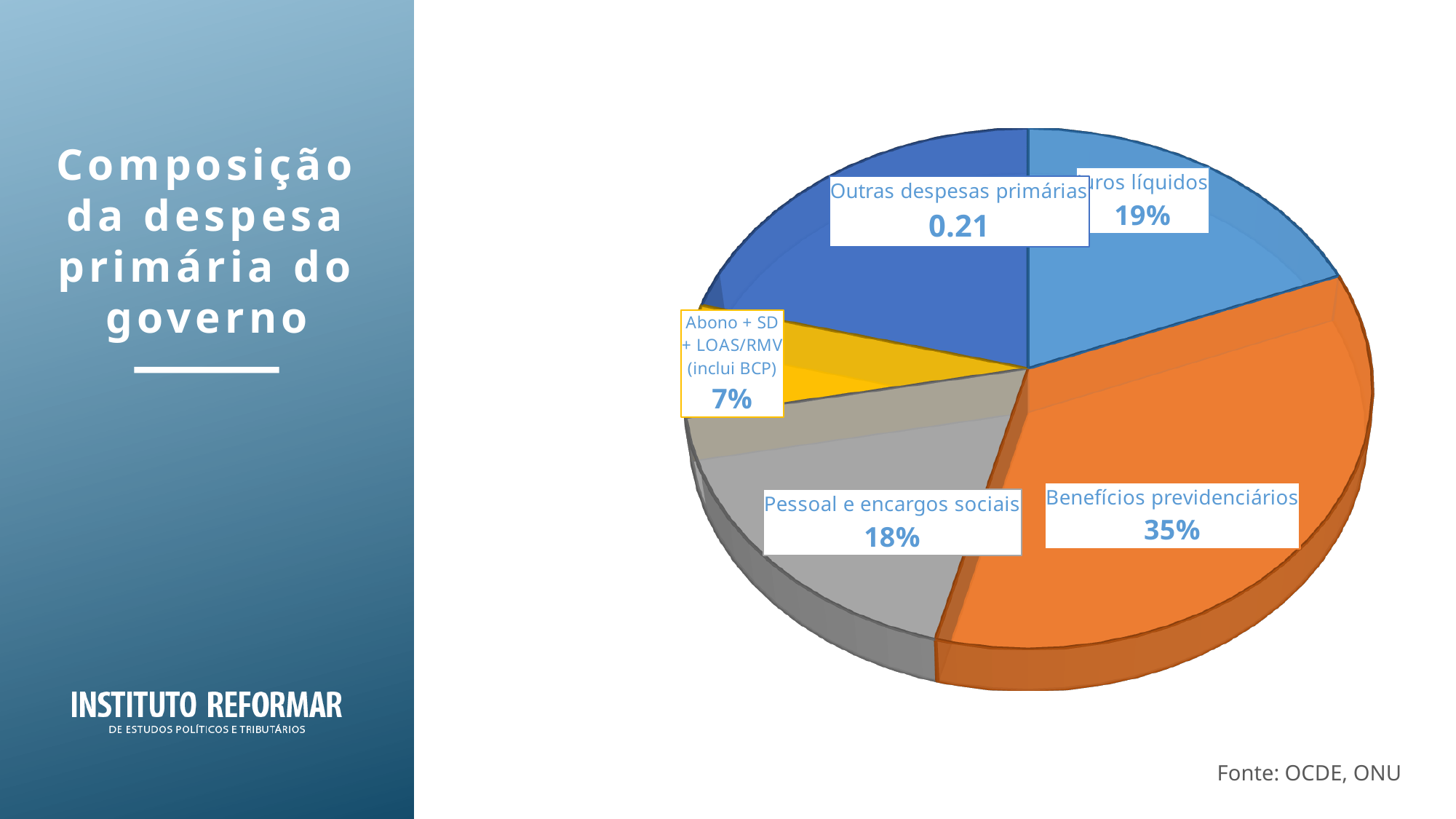
How many percentage points larger is Benefícios previdenciários than Pessoal e encargos sociais? 17 What value is printed on the slice for Abono + SD + LOAS/RMV (inclui BCP)? 7% What value is printed on the slice for Outras despesas primárias? 0.21 What value is shown for Juros líquidos? 19% What share of the pie is labelled for Benefícios previdenciários? 35% What value is shown for Pessoal e encargos sociais? 18% What source is cited for the chart? OCDE, ONU Which category has the largest slice of the pie? Benefícios previdenciários How many slices does the pie chart have? 5 What type of chart is shown on the slide? Pie chart Which is larger, Juros líquidos or Pessoal e encargos sociais? Juros líquidos Which category has the smallest slice of the pie? Abono + SD + LOAS/RMV (inclui BCP)